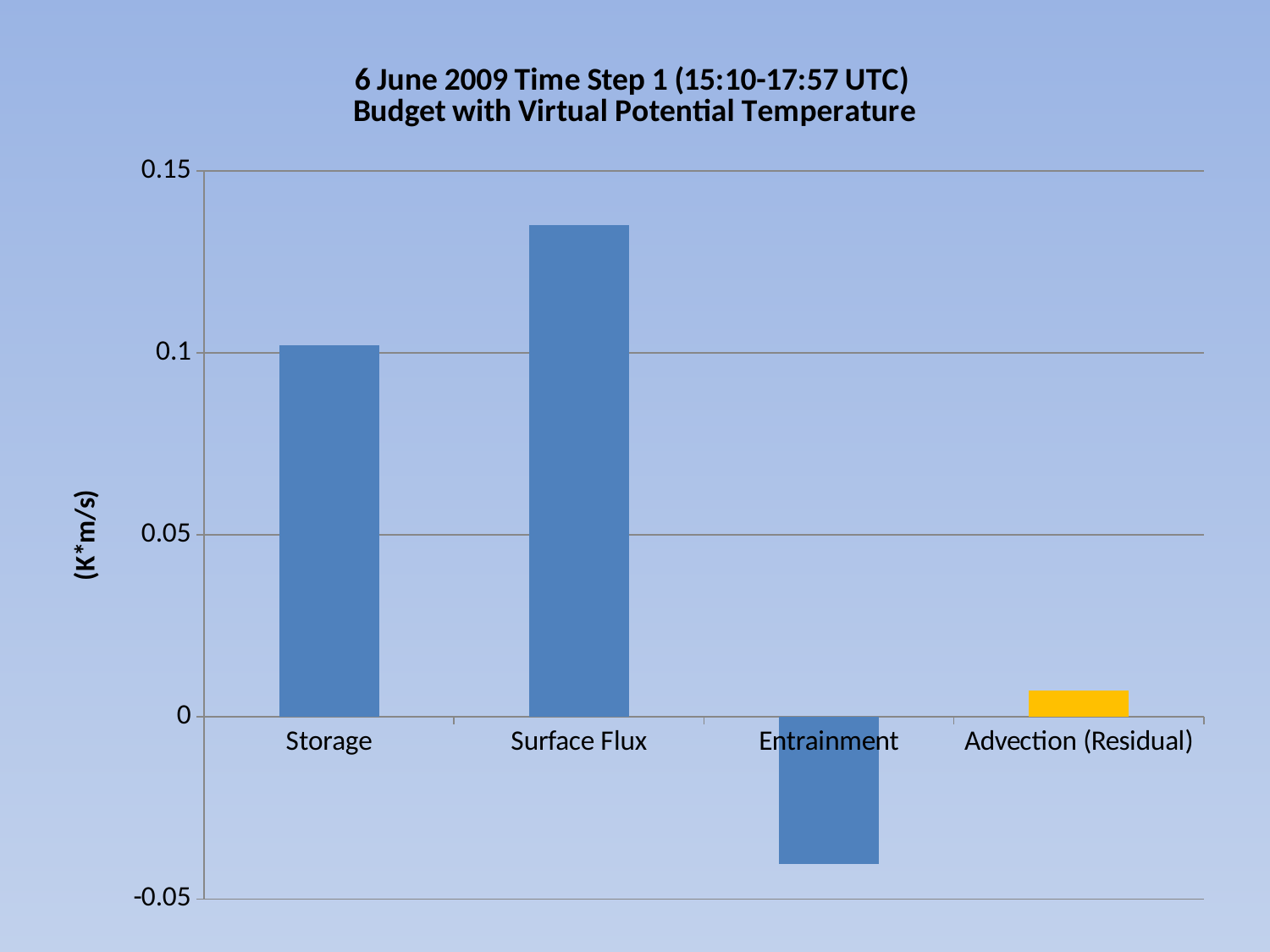
How many categories are plotted on the chart? 4 Which is larger, the value for Storage or the value for Advection (Residual)? Storage Is the value for Surface Flux greater or less than 0.1? greater Is the value for Advection (Residual) greater or less than 0.05? less Is the value for Entrainment greater or less than 0? less Which is larger, the value for Storage or the value for Surface Flux? Surface Flux Which category has the highest value? Surface Flux Which category's bar is coloured differently (yellow) from the others? Advection (Residual) What is the label on the vertical axis of the chart? (K*m/s) Which category has the lowest value? Entrainment What kind of chart is shown on the slide? bar chart